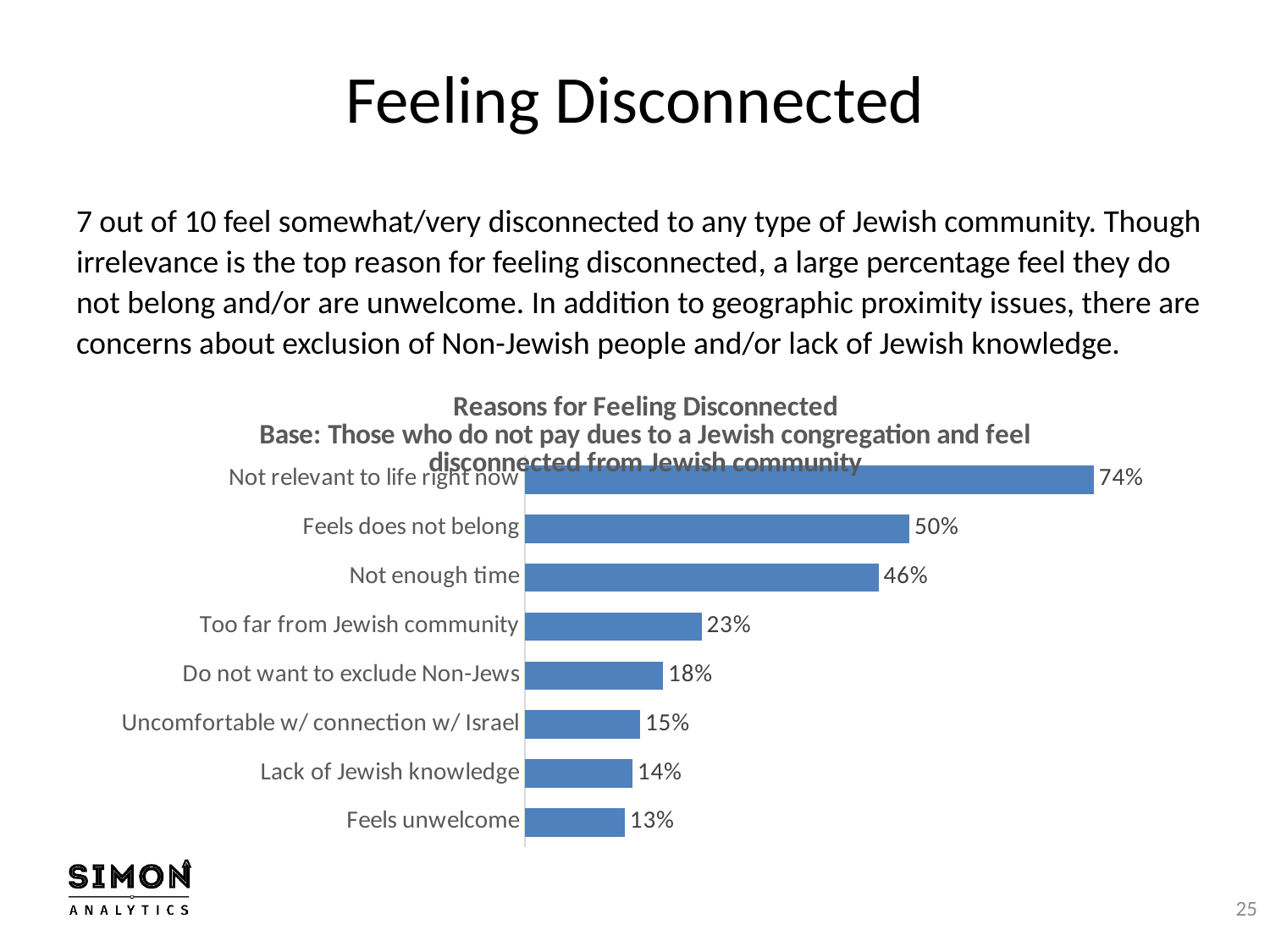
What is the difference between "Feels does not belong" and "Not enough time"? 4% What colour are the bars in the chart? Blue What is the title of the chart? Reasons for Feeling Disconnected What percentage is shown for "Not relevant to life right now"? 74% What is the difference between "Not relevant to life right now" and "Feels unwelcome"? 61% What percentage is shown for "Lack of Jewish knowledge"? 14% What kind of chart is shown on the slide? Bar chart Which reason has the highest percentage? Not relevant to life right now Which is larger, "Do not want to exclude Non-Jews" or "Uncomfortable w/ connection w/ Israel"? Do not want to exclude Non-Jews What is the value for "Too far from Jewish community"? 23% How many reasons are plotted in the chart? 8 Which reason has the lowest percentage? Feels unwelcome